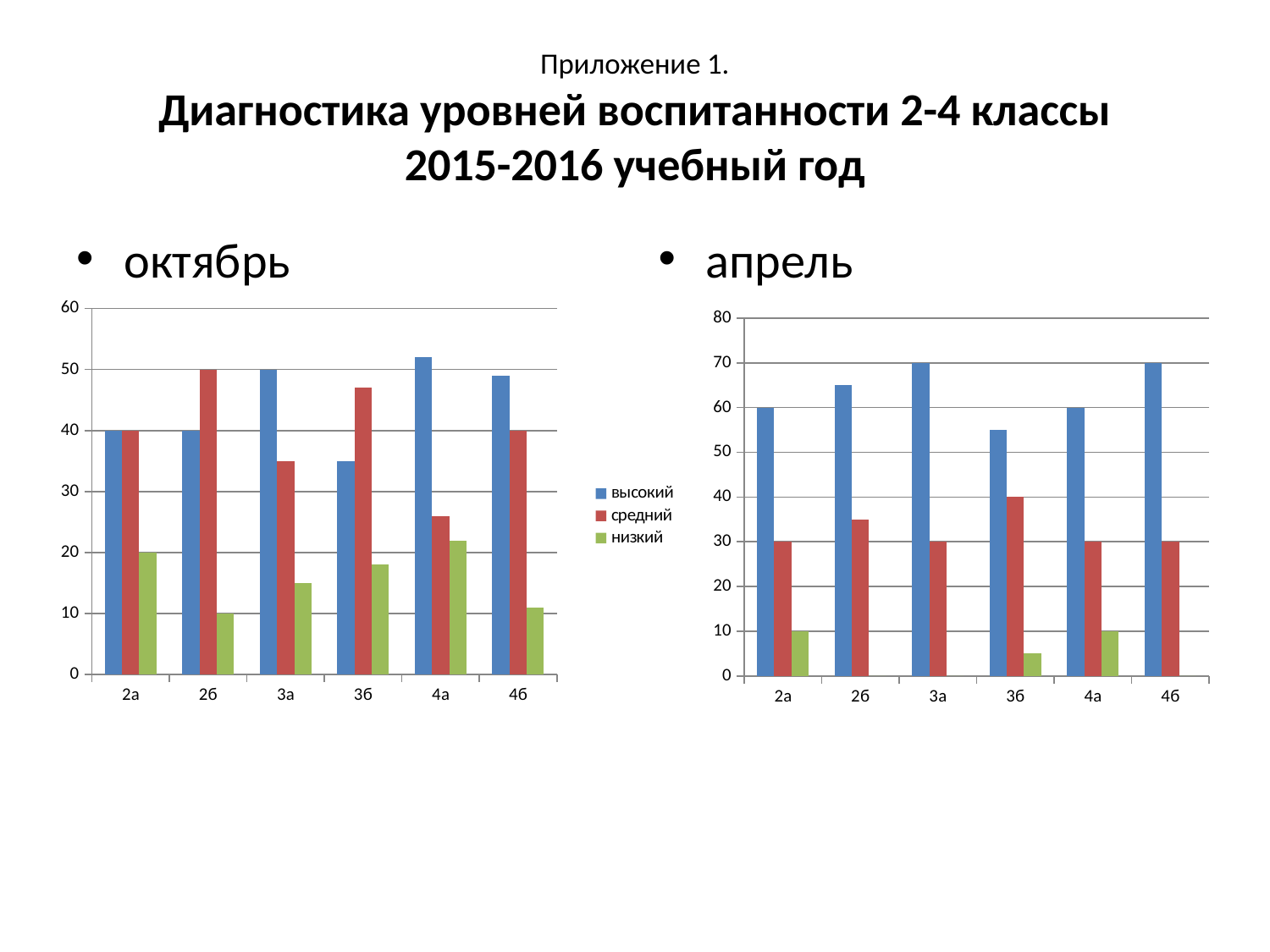
In the октябрь chart, what is the value of низкий for class 2а? 20 In the апрель chart, what is the value of the red bar for class 3б? 40 How many classes are shown on the x axis of the апрель chart? 6 What kind of chart is the октябрь chart on the left? bar chart In the октябрь chart, what is the value of средний for class 2б? 50 In the октябрь chart, is the value of высокий for class 4а greater or less than 50? greater In the октябрь chart, for class 3б, which is larger: высокий or средний? средний In the апрель chart, what is the value of the blue bar for class 3а? 70 How many series does the legend of the октябрь chart list? 3 In the октябрь chart, which colour represents низкий in the legend? green In the апрель chart, which class has the lowest blue bar? 3б In the октябрь chart, what is the value of высокий for class 2а? 40